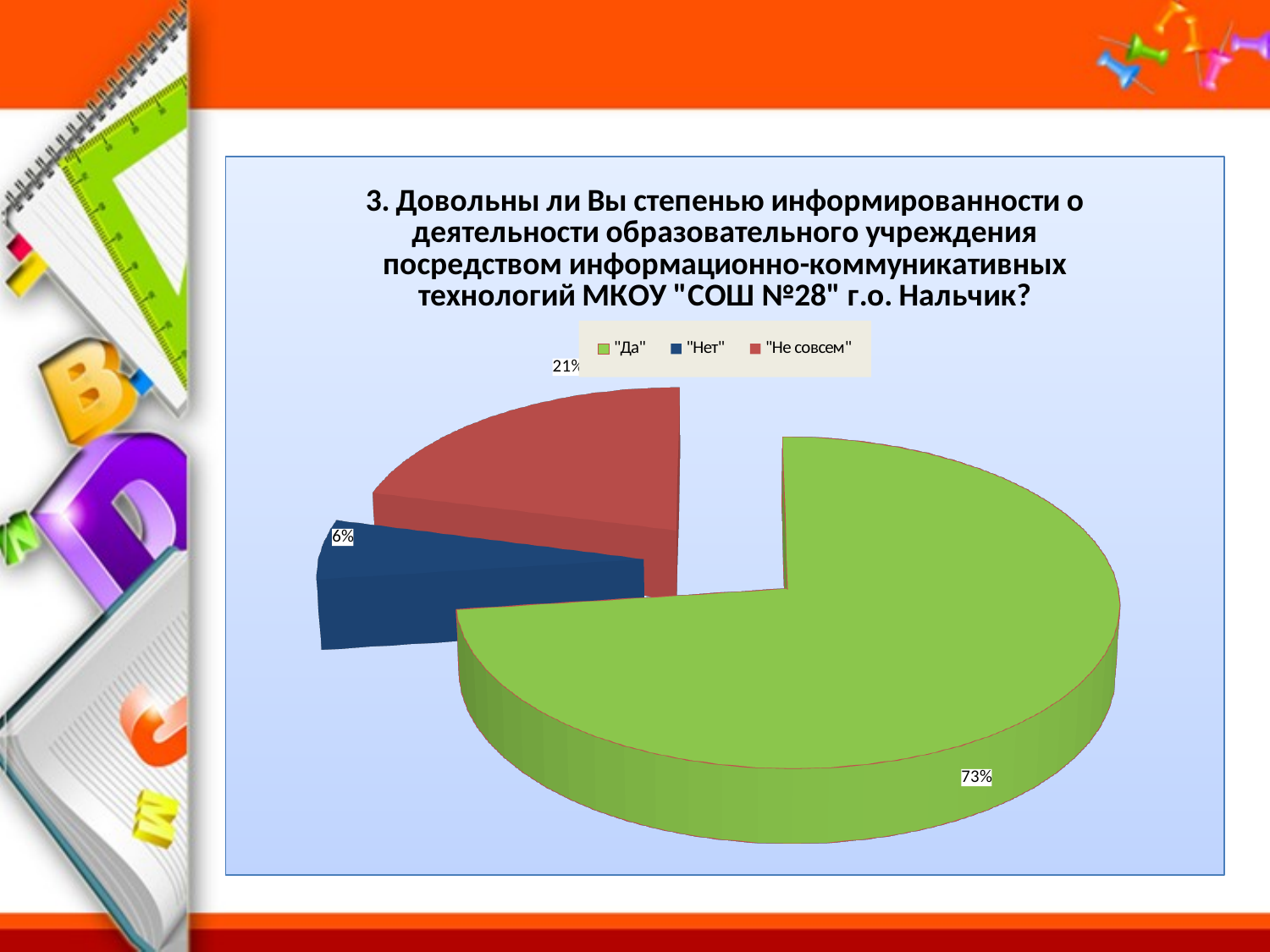
Which answer has the largest share of the pie? "Да" What colour is the slice for "Нет"? dark blue How many slices does the pie chart have? 3 How many entries does the legend list? 3 Which is larger, the share for "Нет" or the share for "Не совсем"? "Не совсем" What percentage of respondents answered "Нет"? 6% Which answer has the smallest share of the pie? "Нет" What percentage of respondents answered "Не совсем"? 21% What kind of chart is shown on the slide? pie chart What is the difference in percentage points between "Да" and "Не совсем"? 52 What percentage of respondents answered "Да"? 73% What is the difference in percentage points between "Не совсем" and "Нет"? 15